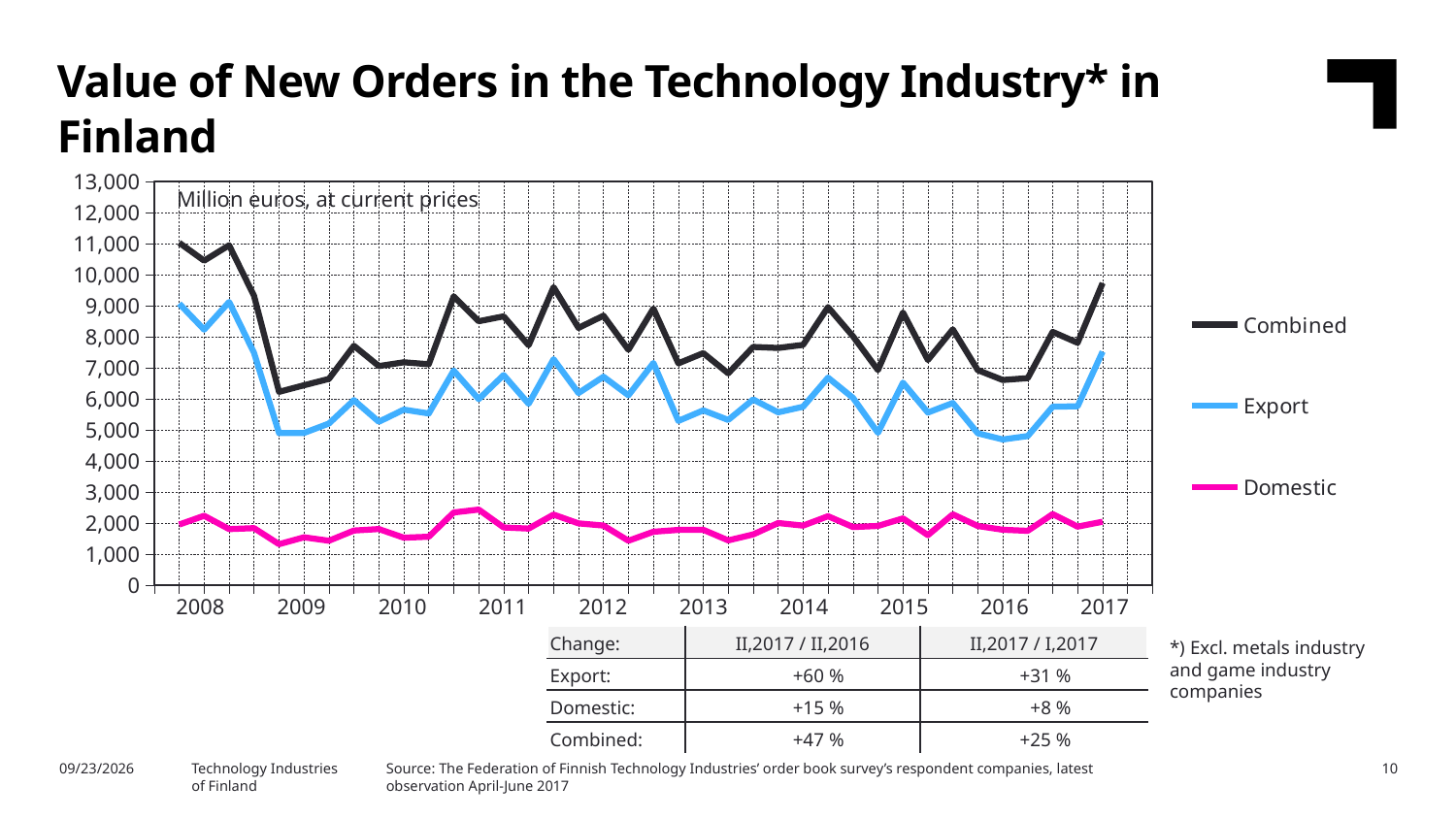
Does the Combined series rise or fall between the start of 2008 and the start of 2009? Fall How many series does the legend list? 3 Is the last plotted value for Combined in 2017 greater or less than 9,000? greater Is the value for Combined at the start of 2009 greater or less than 5,000? greater Is the value for Domestic at the start of 2008 greater or less than 3,000? less Which series has the lowest values throughout the chart? Domestic What unit is stated inside the chart area? Million euros, at current prices How many years are labelled on the x axis? 10 What kind of chart is shown on the slide? Line chart Which is larger at the start of 2012, the Export value or the Domestic value? Export Which series has the highest values throughout the chart? Combined